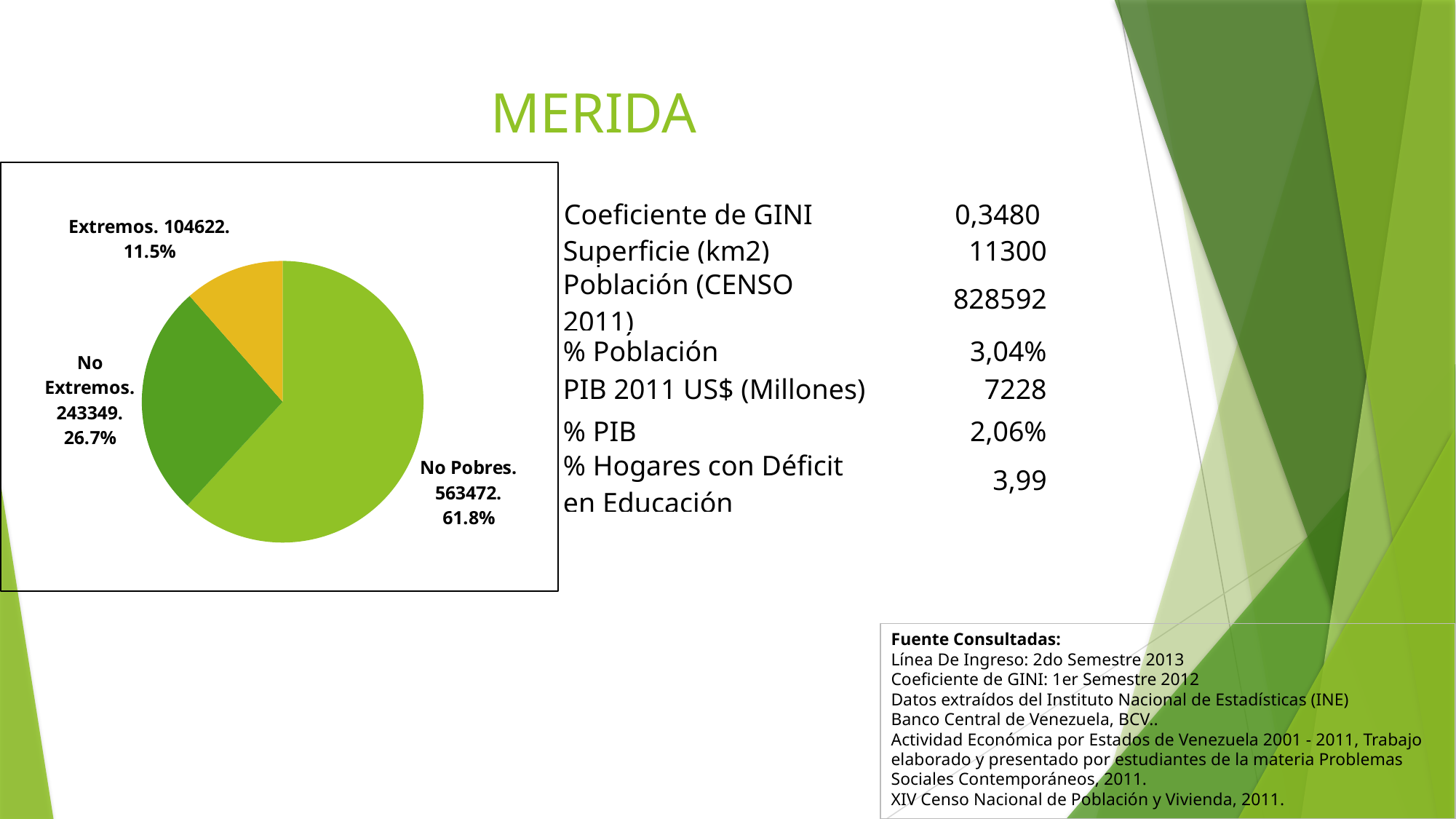
Which slice is larger, No Extremos or Extremos? No Extremos What is the value shown for the Extremos slice? 104622 What is the difference between the No Extremos value and the Extremos value? 138727 What share of the pie does the No Pobres slice represent? 61.8% What is the value shown for the No Pobres slice? 563472 What is the value shown for the No Extremos slice? 243349 How many slices does the pie chart have? 3 What share of the pie does the Extremos slice represent? 11.5% What kind of chart is shown on the slide? pie chart Which slice of the pie chart is the smallest? Extremos What share of the pie does the No Extremos slice represent? 26.7% Which slice of the pie chart is the largest? No Pobres